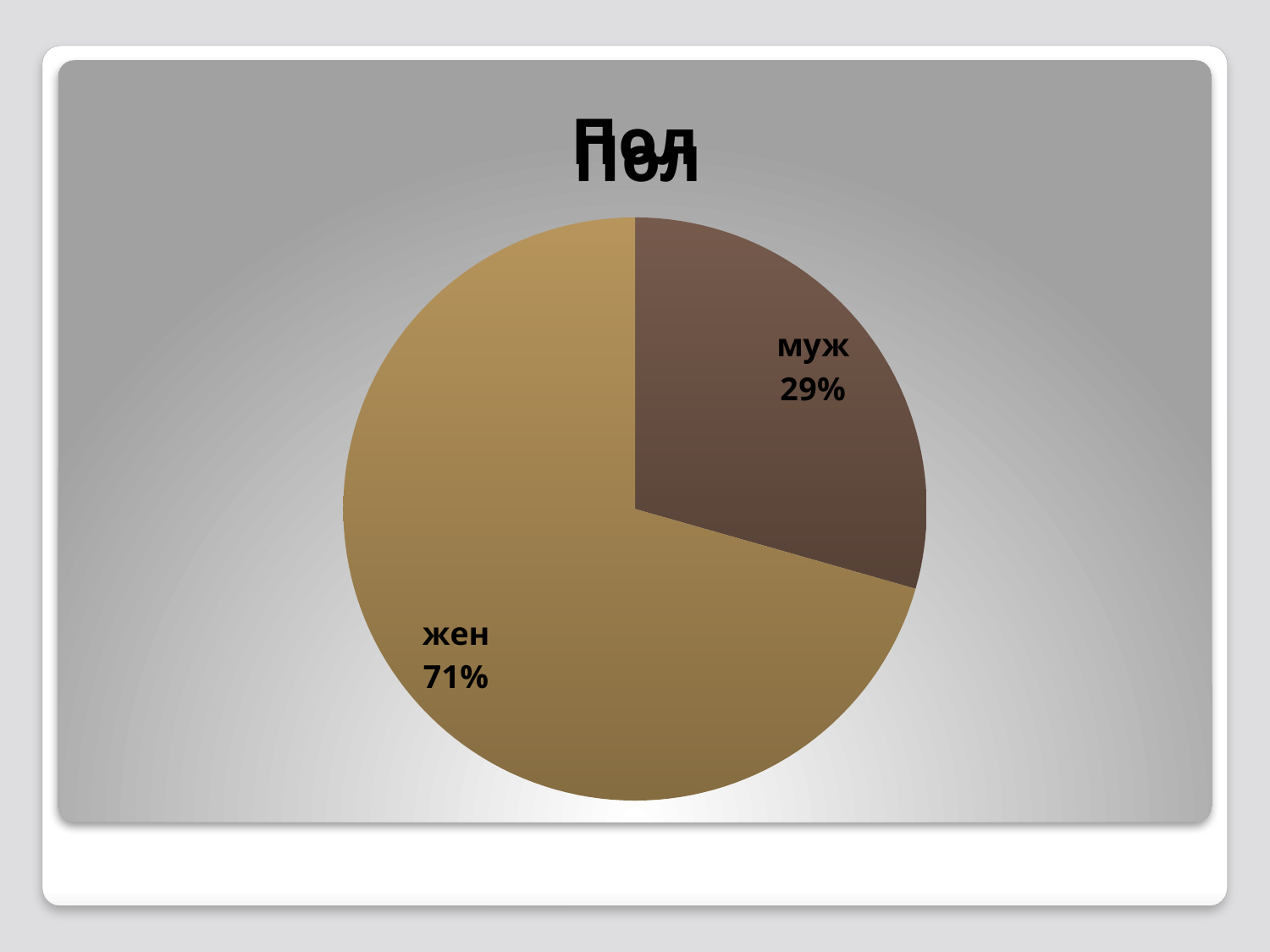
Which slice of the pie chart is the smallest? муж Which slice of the pie chart is the largest? жен How many slices does the pie chart have? 2 What colour is the "муж" slice of the pie chart? Dark brown What percentage of the pie chart is labelled "жен"? 71% What percentage of the pie chart is labelled "муж"? 29% What share of the pie does the "муж" slice represent? 29% What colour is the "жен" slice of the pie chart? Golden tan Is the "жен" slice more or less than half of the pie? More Which slice is larger, "муж" or "жен"? жен By how many percentage points does the "жен" slice exceed the "муж" slice? 42 percentage points What kind of chart is shown on the slide? Pie chart